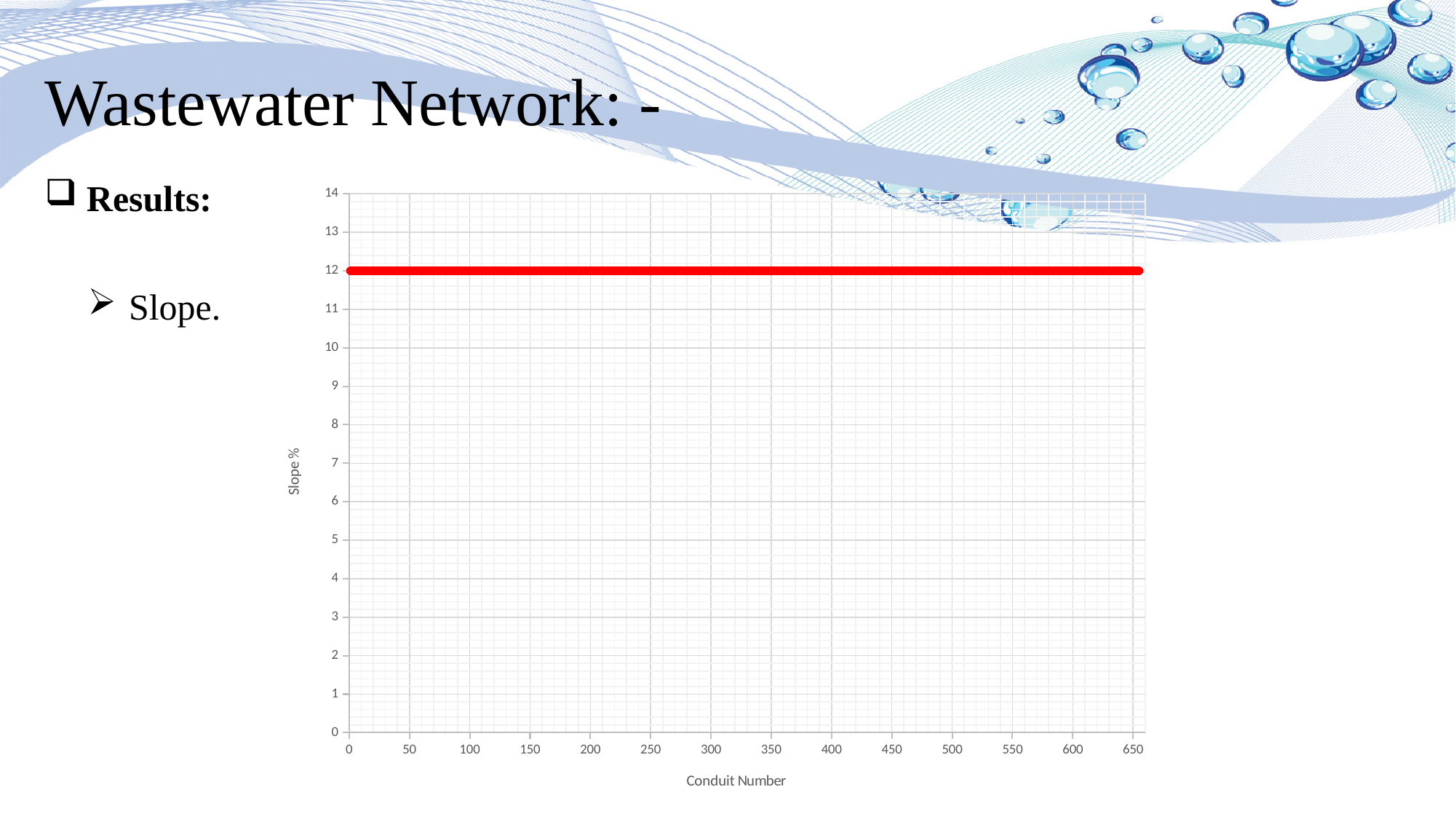
Is the slope % value for conduit number 600 greater or less than 5? greater What slope % value does the red line sit on across all conduit numbers? 12 What is the highest value shown on the y axis of the chart? 14 What is the label of the y axis of the chart? Slope % What is the label of the x axis of the chart? Conduit Number What kind of chart is shown on the slide? line chart Is the slope % value at conduit number 50 larger than, smaller than, or equal to the value at conduit number 500? equal Do the plotted slope values rise, fall, or stay constant as the conduit number increases? stay constant Is the slope % value for conduit number 300 greater or less than 10? greater Is the slope % value for conduit number 100 greater or less than 13? less